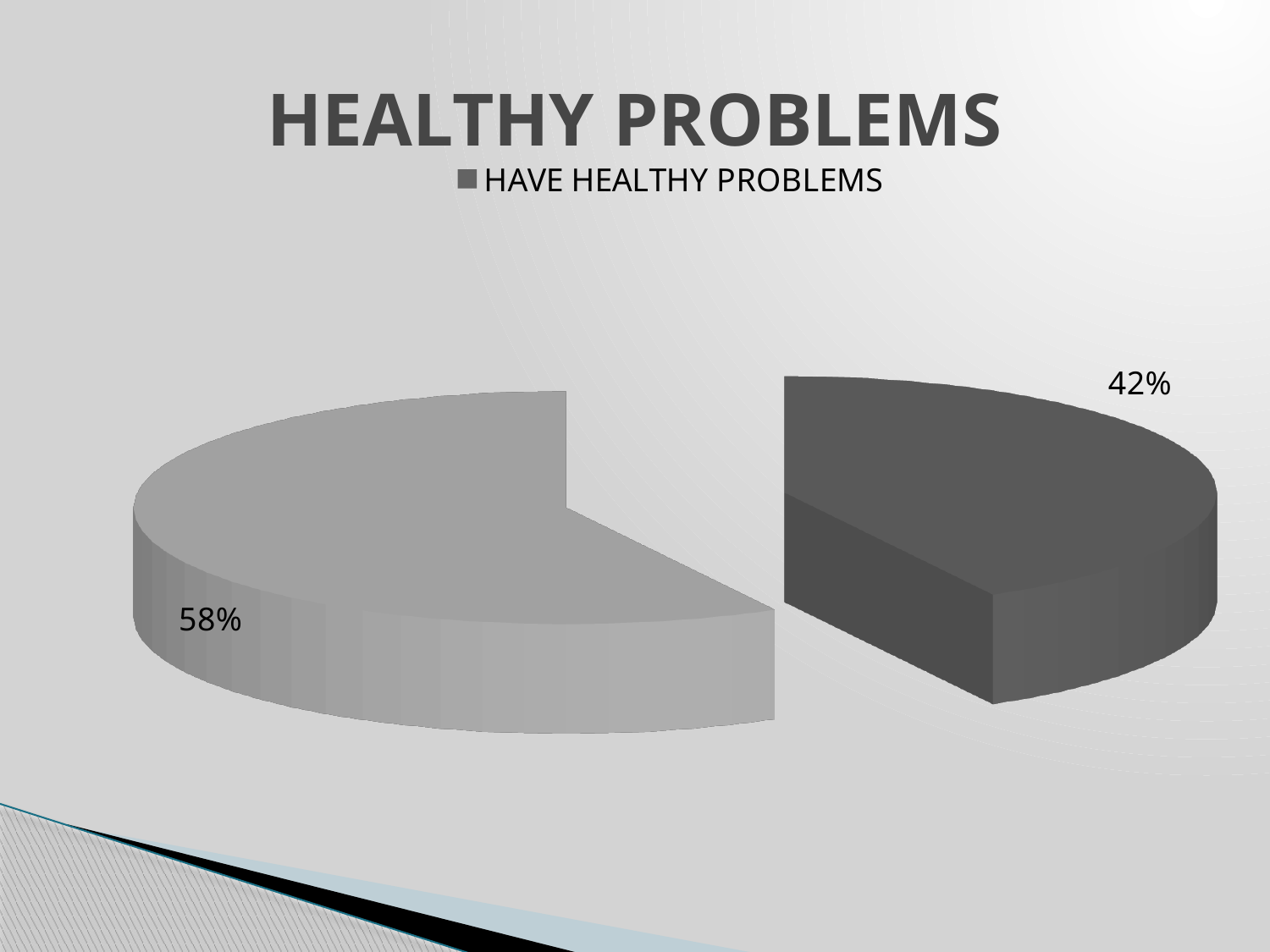
How many entries does the legend list? 1 What is the difference in percentage points between the two slices? 16 What percentage is shown on the light grey slice on the left? 58% How many slices does the pie chart have? 2 What is the title of the chart? HEALTHY PROBLEMS Is the dark grey slice's share greater or less than 50%? less What entry does the chart's legend list? HAVE HEALTHY PROBLEMS What percentage is shown on the dark grey slice on the right? 42% What kind of chart is shown on the slide? pie chart What is the value of the smallest slice of the pie? 42% Which slice is larger, the light grey one or the dark grey one? the light grey one What is the value of the largest slice of the pie? 58%